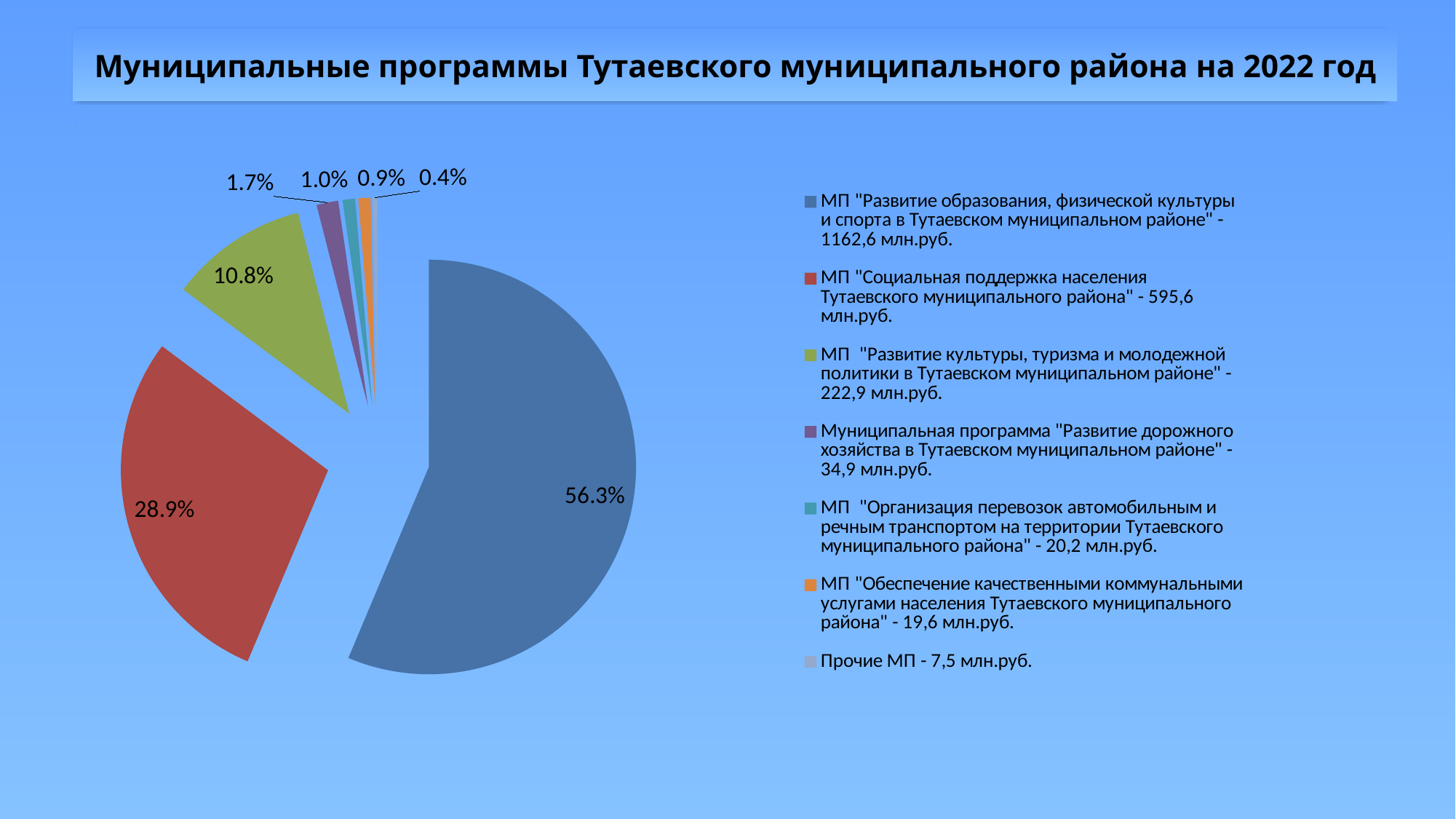
According to the legend, what is the amount in млн.руб. for the program "Социальная поддержка населения Тутаевского муниципального района"? 595,6 млн.руб. What is the difference in percentage points between the 56.3% slice and the 28.9% slice? 27.4 What type of chart is shown on the slide? pie chart How many entries does the legend list? 7 What share of the pie does the program "Социальная поддержка населения Тутаевского муниципального района" take? 28.9% Which is larger: the share for "Организация перевозок автомобильным и речным транспортом" or the share for "Обеспечение качественными коммунальными услугами"? Организация перевозок автомобильным и речным транспортом Which legend entry has the smallest slice of the pie? Прочие МП What share of the pie does the program "Развитие культуры, туризма и молодежной политики в Тутаевском муниципальном районе" take? 10.8% How many slices does the pie chart have? 7 What share of the pie does the program "Развитие дорожного хозяйства в Тутаевском муниципальном районе" take? 1.7% Which program has the largest slice of the pie? МП "Развитие образования, физической культуры и спорта в Тутаевском муниципальном районе"